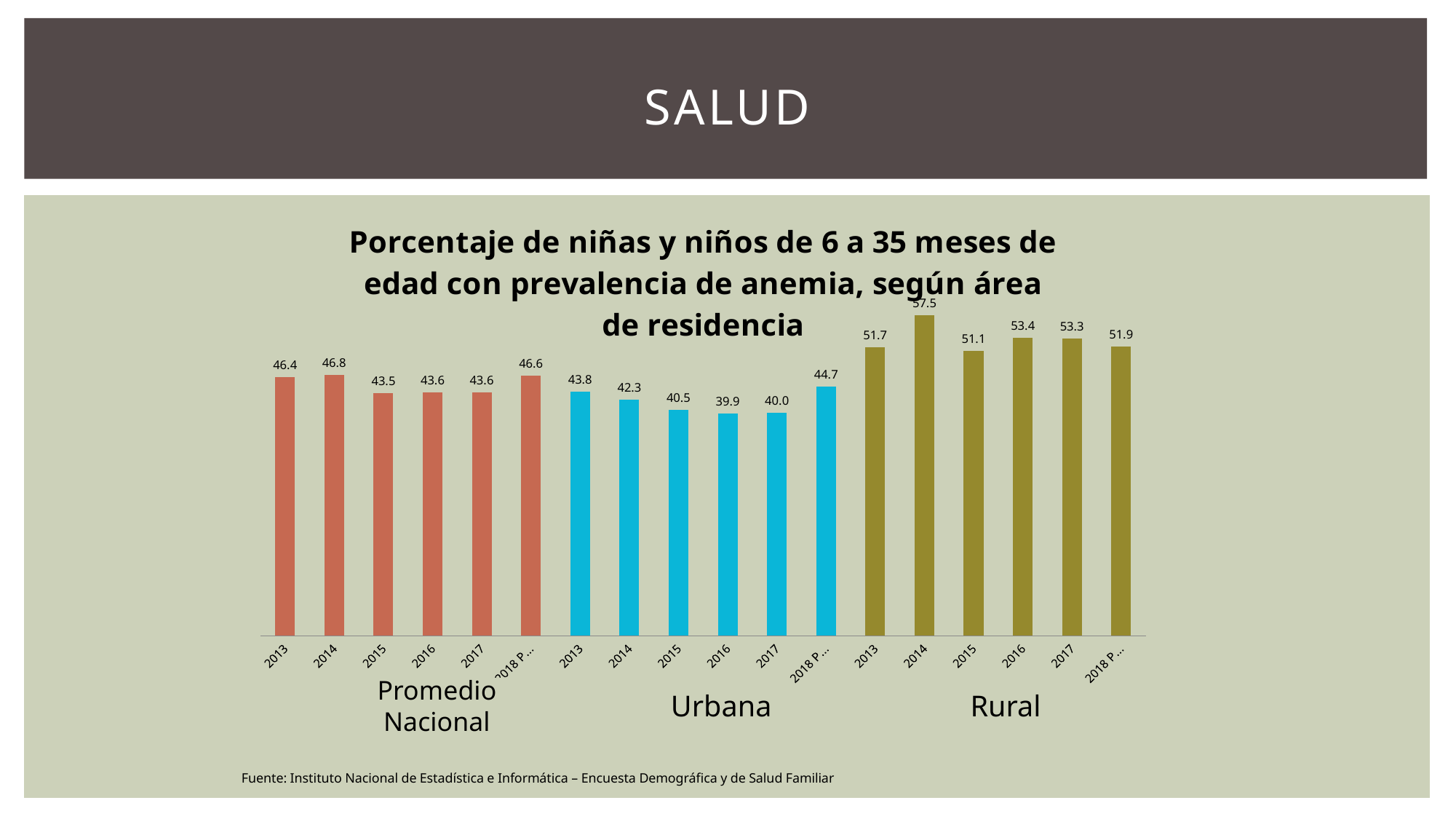
How many bars are plotted in the chart in total? 18 What is the value for Promedio Nacional in 2015? 43.5 What is the difference between the Rural value in 2014 and the Rural value in 2015? 6.4 Which year has the lowest value in the Urbana group? 2016 What is the value for Rural in 2014? 57.5 Which is larger, the Rural value in 2016 or the Rural value in 2013? Rural 2016 What kind of chart is shown on the slide? Bar chart Which year has the highest value in the Rural group? 2014 What is the value for Urbana in 2016? 39.9 What is the difference between the Promedio Nacional value in 2014 and the Urbana value in 2014? 4.5 How many area-of-residence groups are shown along the x axis? 3 What is the value for Urbana in 2013? 43.8